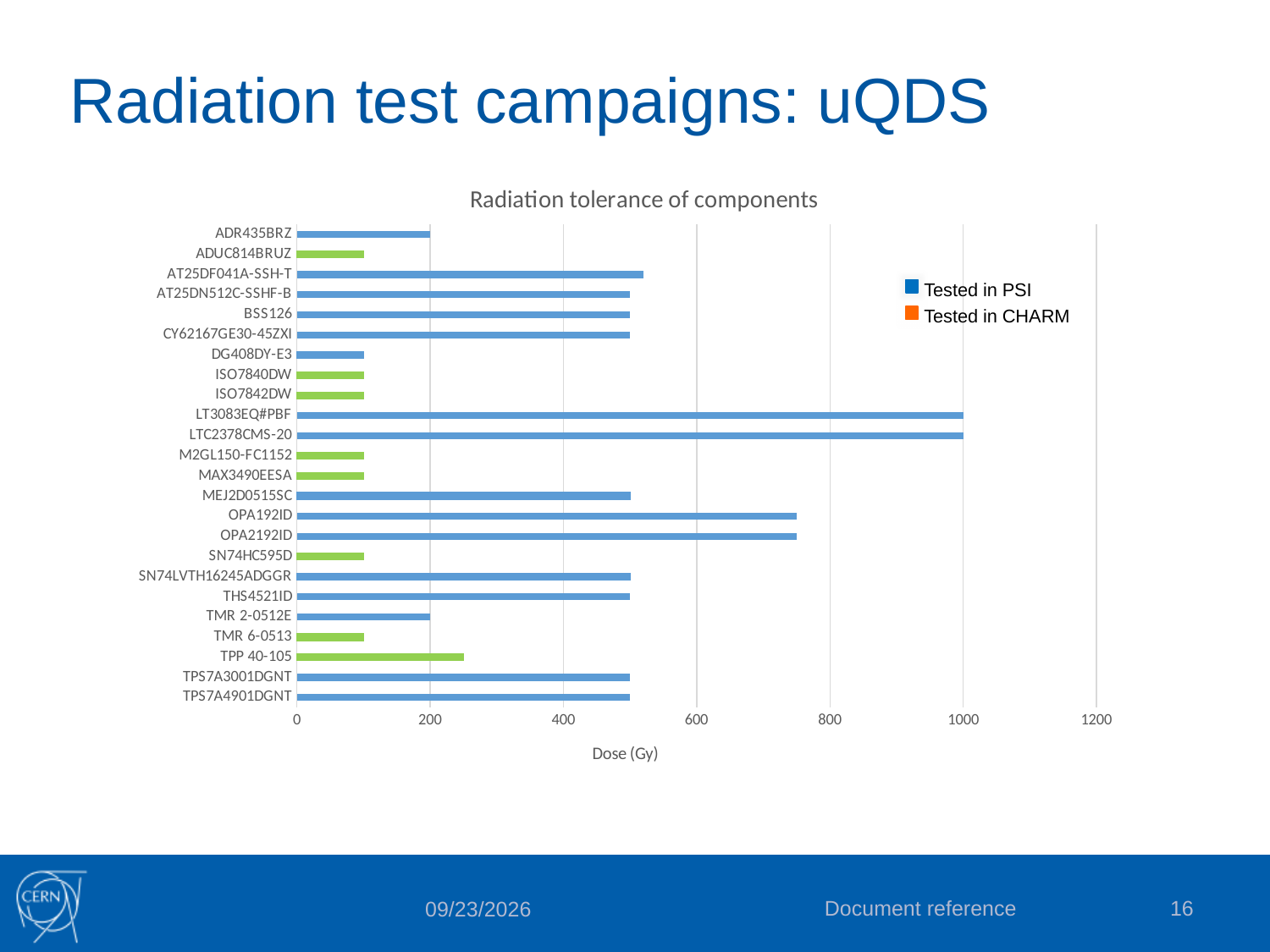
How many components are listed on the chart's vertical axis? 24 What is the dose value for LT3083EQ#PBF? 1000 Is the value for OPA192ID greater or less than 600? greater What is the title of the chart? Radiation tolerance of components Which has a larger dose value, OPA2192ID or BSS126? OPA2192ID Is the value for ISO7840DW greater or less than 200? less What is the dose value for TMR 2-0512E? 200 What type of chart is shown on the slide? Bar chart What is the label of the horizontal axis? Dose (Gy) What is the difference between the dose values for LT3083EQ#PBF and ADR435BRZ? 800 How many series does the legend list? 2 What is the dose value for ADR435BRZ? 200